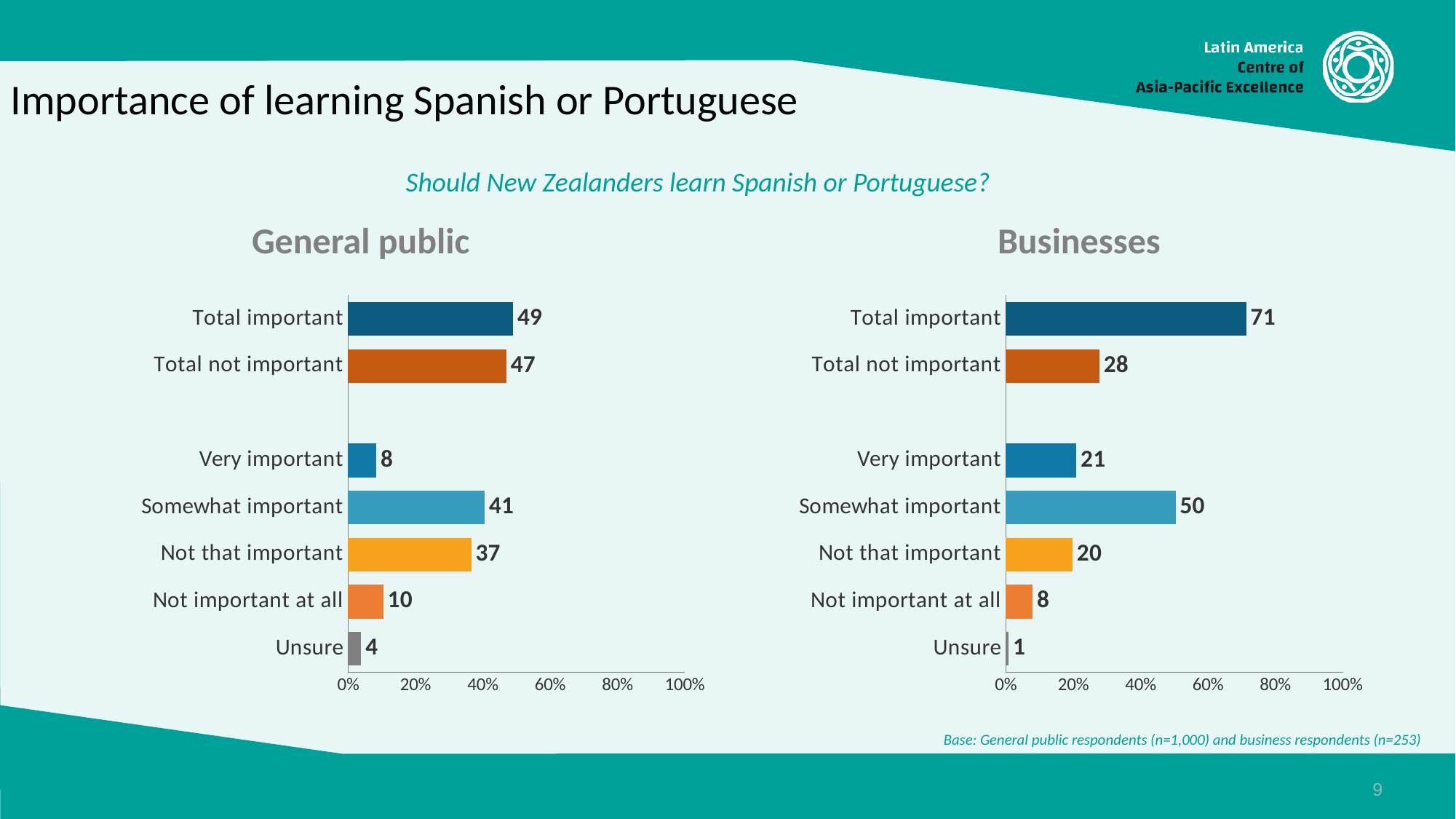
In the General public chart, what is the difference between Somewhat important and Not that important? 4 How many categories are shown in the General public chart? 7 In the Businesses chart, is the value for Somewhat important greater or less than 40%? greater In the General public chart, what is the value for Somewhat important? 41 In the Businesses chart, which category has the highest value? Total important In the General public chart, which category has the lowest value? Unsure In the General public chart, which is larger: Very important or Not important at all? Not important at all In the Businesses chart, what is the value for Total important? 71 What is the title of the chart on the left? General public In the Businesses chart, what is the value for Not that important? 20 What kind of chart is the Businesses chart? bar chart In the Businesses chart, what is the difference between Total important and Total not important? 43